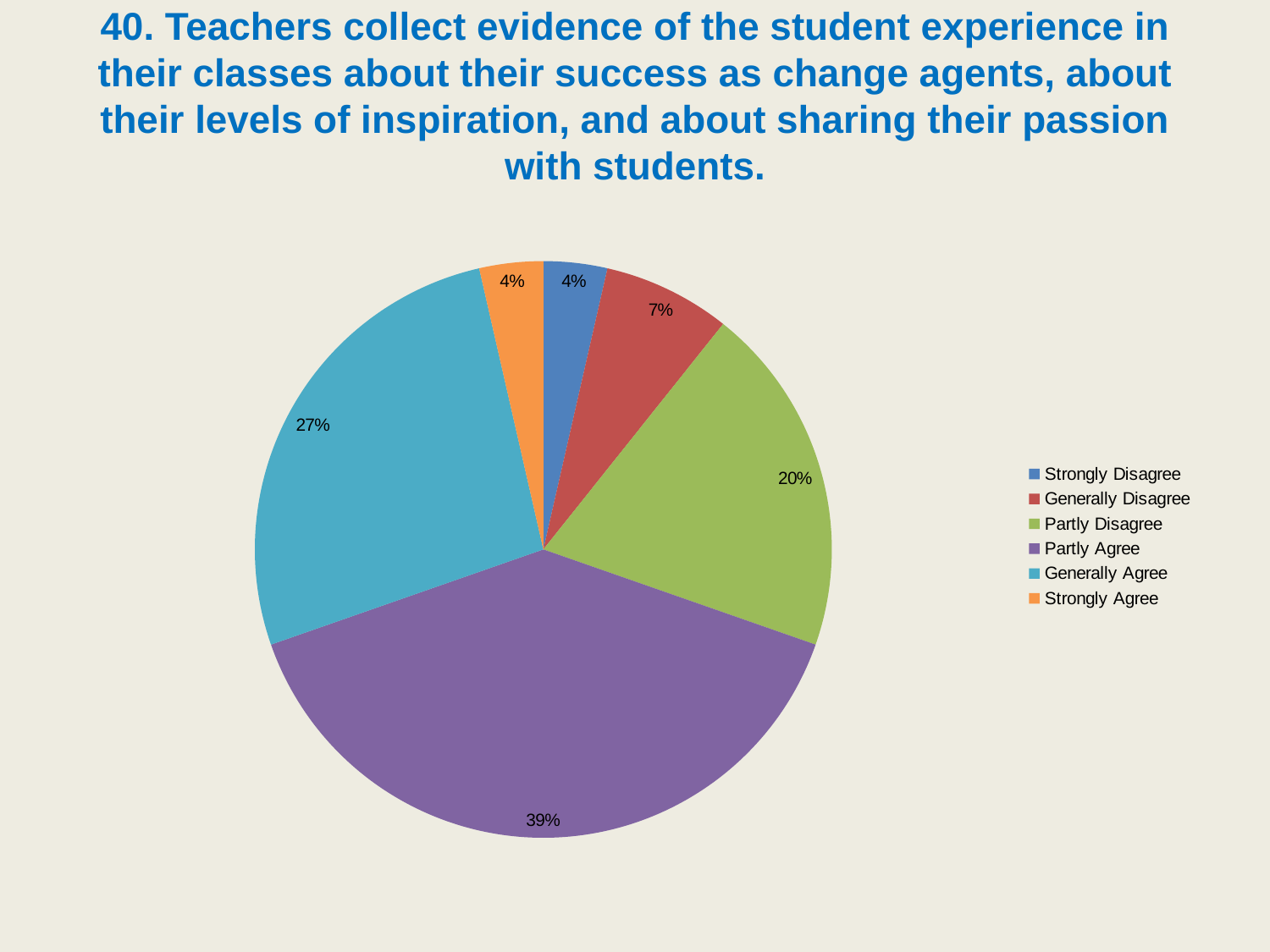
What percentage of respondents chose Partly Disagree? 20% What percentage of respondents chose Generally Disagree? 7% Which response category has the largest share of the pie? Partly Agree What kind of chart is shown on the slide? Pie chart Which colour represents Generally Agree in the legend? Teal (light blue) How many response categories does the legend list? 6 What is the difference in percentage points between Partly Agree and Generally Agree? 12 What is the combined share of Partly Agree, Generally Agree and Strongly Agree? 70% Which is larger, the share for Partly Disagree or the share for Generally Disagree? Partly Disagree What percentage of respondents chose Strongly Agree? 4% What percentage of respondents chose Generally Agree? 27% What percentage of respondents chose Partly Agree? 39%